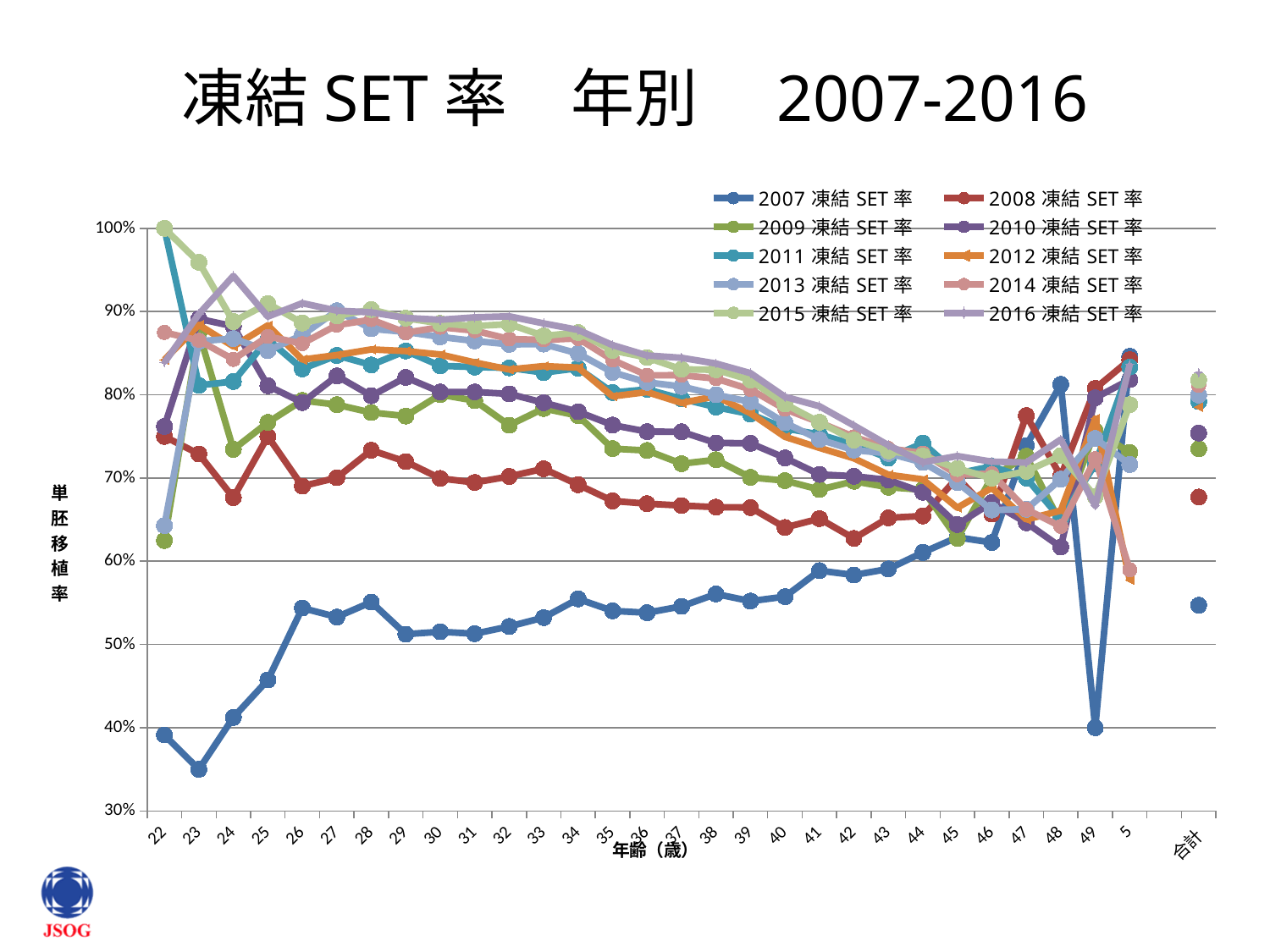
Does the 2007 凍結 SET 率 series generally rise or fall from age 22 to age 44? rise Is the value for 2008 凍結 SET 率 at 合計 greater or less than 70%? less Is the value for 2007 凍結 SET 率 at 合計 greater or less than 60%? less What is the label on the x axis of the chart? 年齢（歳） How many series does the legend list? 10 What kind of chart is shown on the slide? line chart What is the title of the chart? 凍結 SET 率 年別 2007-2016 Is the value for 2008 凍結 SET 率 at age 22 greater or less than 70%? greater Which series has the lowest value at age 35? 2007 凍結 SET 率 At age 30, which is larger: 2007 凍結 SET 率 or 2008 凍結 SET 率? 2008 凍結 SET 率